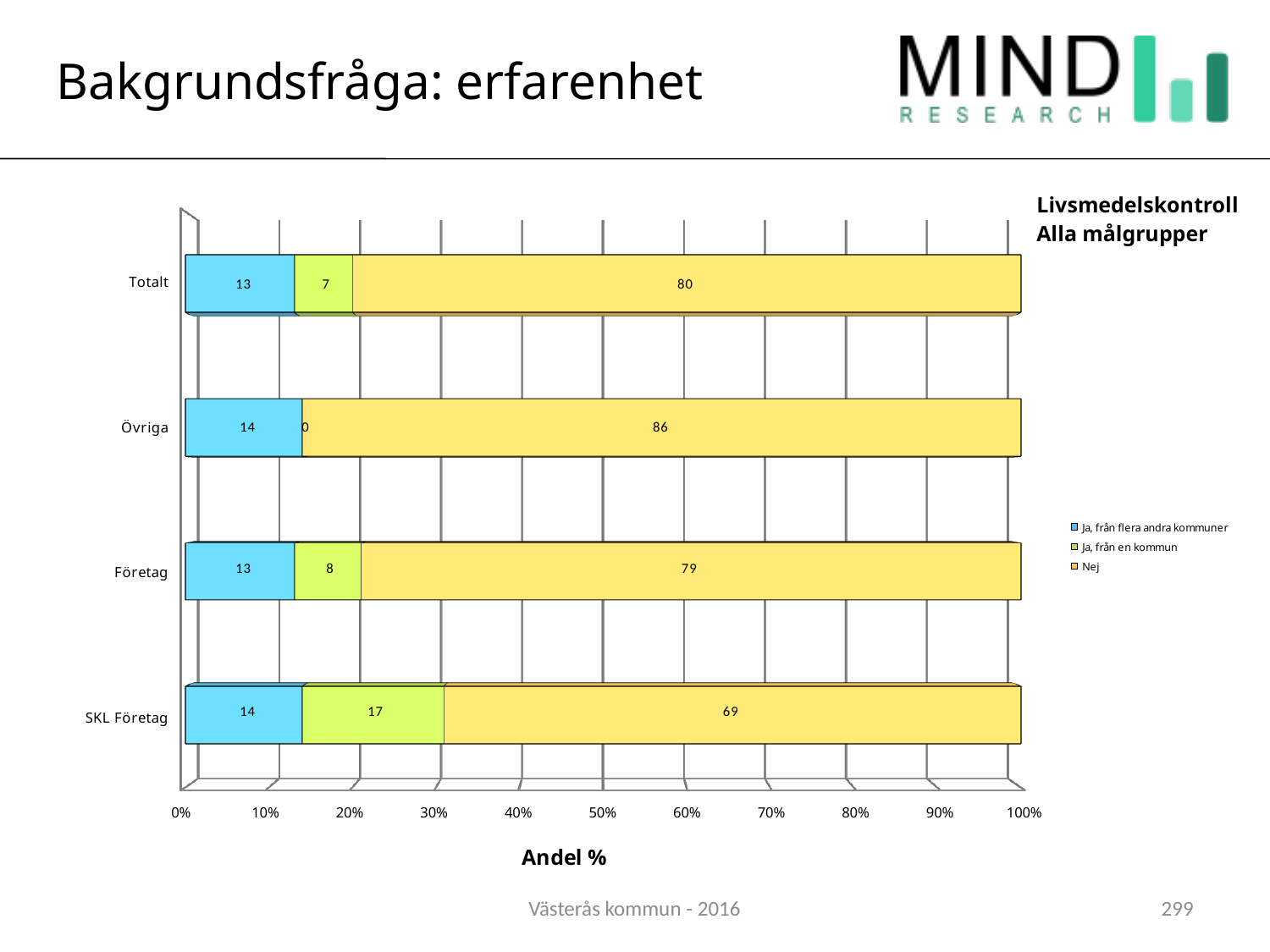
What is the value of "Ja, från flera andra kommuner" for Övriga? 14 What is the label of the horizontal axis? Andel % How many series does the legend list? 3 What is the value of "Ja, från en kommun" for SKL Företag? 17 What is the value of "Nej" for Totalt? 80 How many categories are shown on the vertical axis? 4 What is the difference between the "Nej" values for Övriga and SKL Företag? 17 Which category has the highest value for "Nej"? Övriga Which category has the lowest value for "Nej"? SKL Företag What is the value of "Ja, från en kommun" for Övriga? 0 What kind of chart is shown on the slide? Stacked bar chart Which is larger: the "Ja, från en kommun" value for Företag or for SKL Företag? SKL Företag